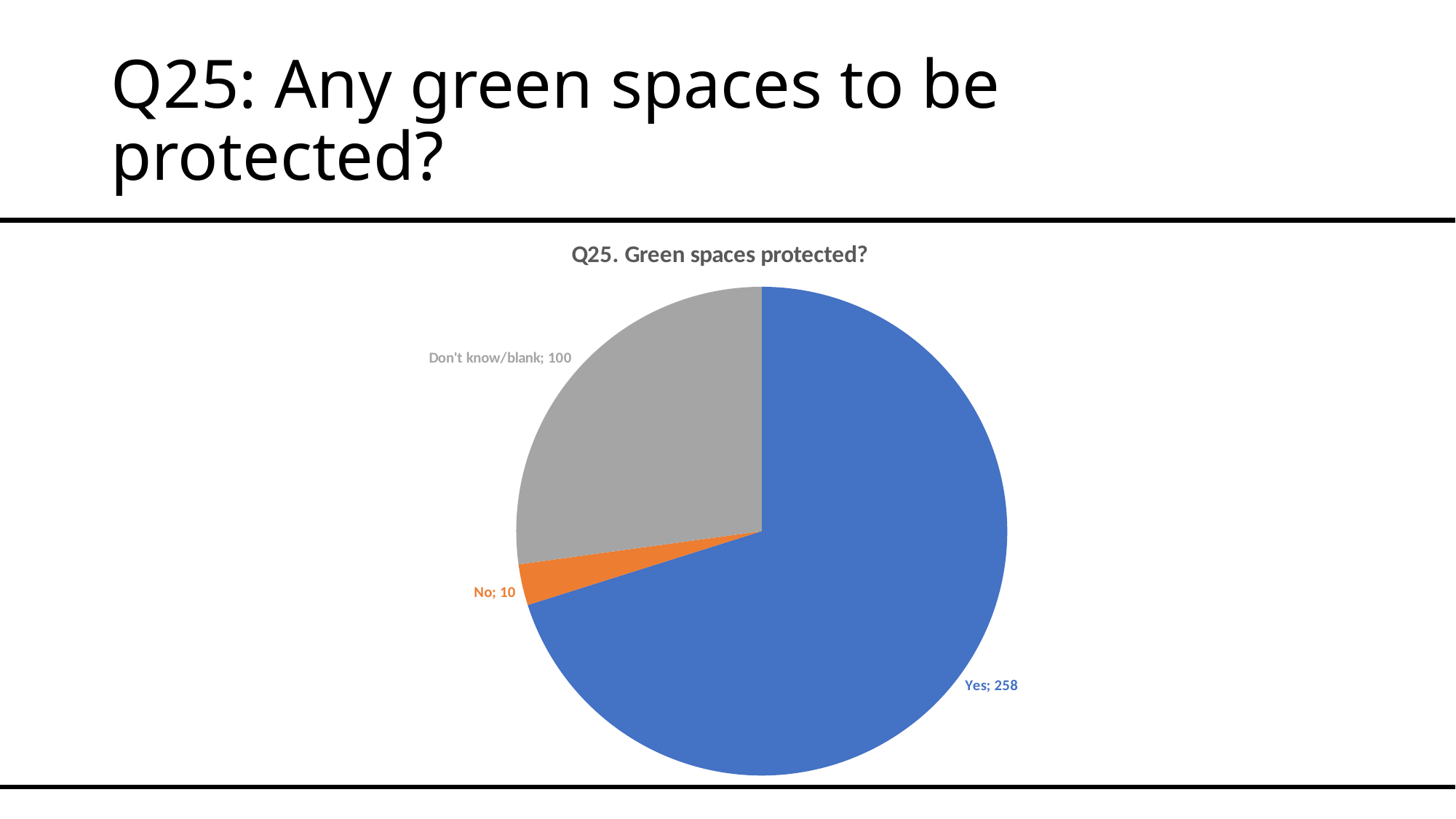
What is the value for Don't know/blank in the pie chart? 100 Which category has the smallest slice of the pie chart? No What is the difference between the Yes and Don't know/blank values? 158 What is the difference between the Don't know/blank and No values? 90 What is the value for Yes in the pie chart? 258 What is the total of all slices in the pie chart? 368 What is the title of the chart? Q25. Green spaces protected? Which is larger, the value for Don't know/blank or the value for No? Don't know/blank How many categories are shown in the pie chart? 3 Which category has the largest slice of the pie chart? Yes What is the value for No in the pie chart? 10 What kind of chart is shown on the slide? Pie chart